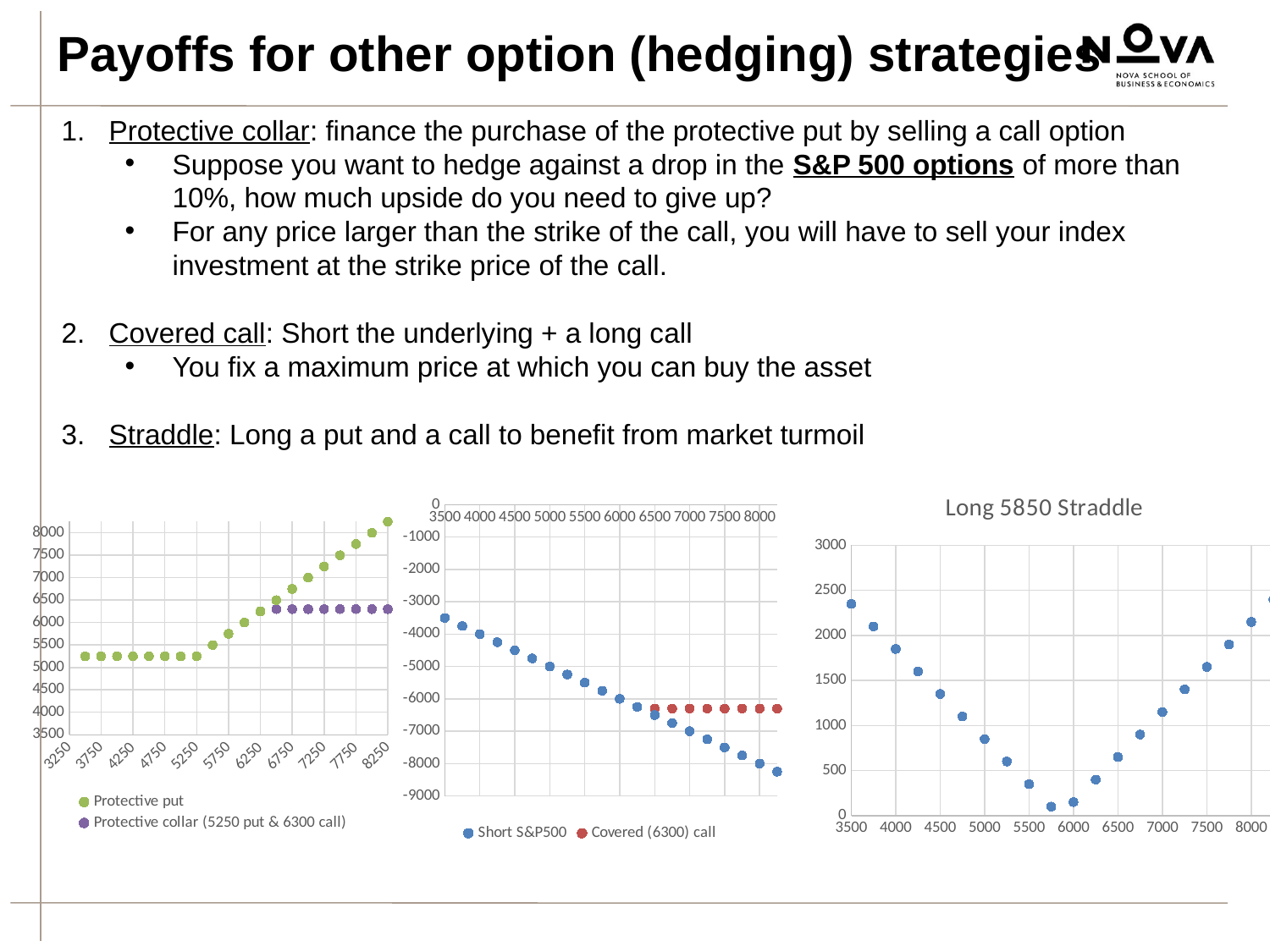
In the left-hand chart, at 8250 which series has the higher value, Protective put or Protective collar? Protective put How many series does the legend of the left-hand chart list? 2 In the Long 5850 Straddle chart, do the values rise or fall as the x-axis moves from 3500 to 5500? fall In the middle chart, do the Short S&P500 values rise or fall as the x-axis value increases? fall How many series does the legend of the middle chart list? 2 In the left-hand chart, is the Protective put value at 3750 greater or less than 5000? greater In the left-hand chart, is the Protective collar (5250 put & 6300 call) value at 8250 greater or less than 7000? less In the middle chart, what are the two legend entries? Short S&P500 and Covered (6300) call In the Long 5850 Straddle chart, is the value at 3500 greater or less than 2000? greater What is the title of the right-hand chart? Long 5850 Straddle What kind of chart is the left-hand chart with the Protective put and Protective collar series? scatter chart